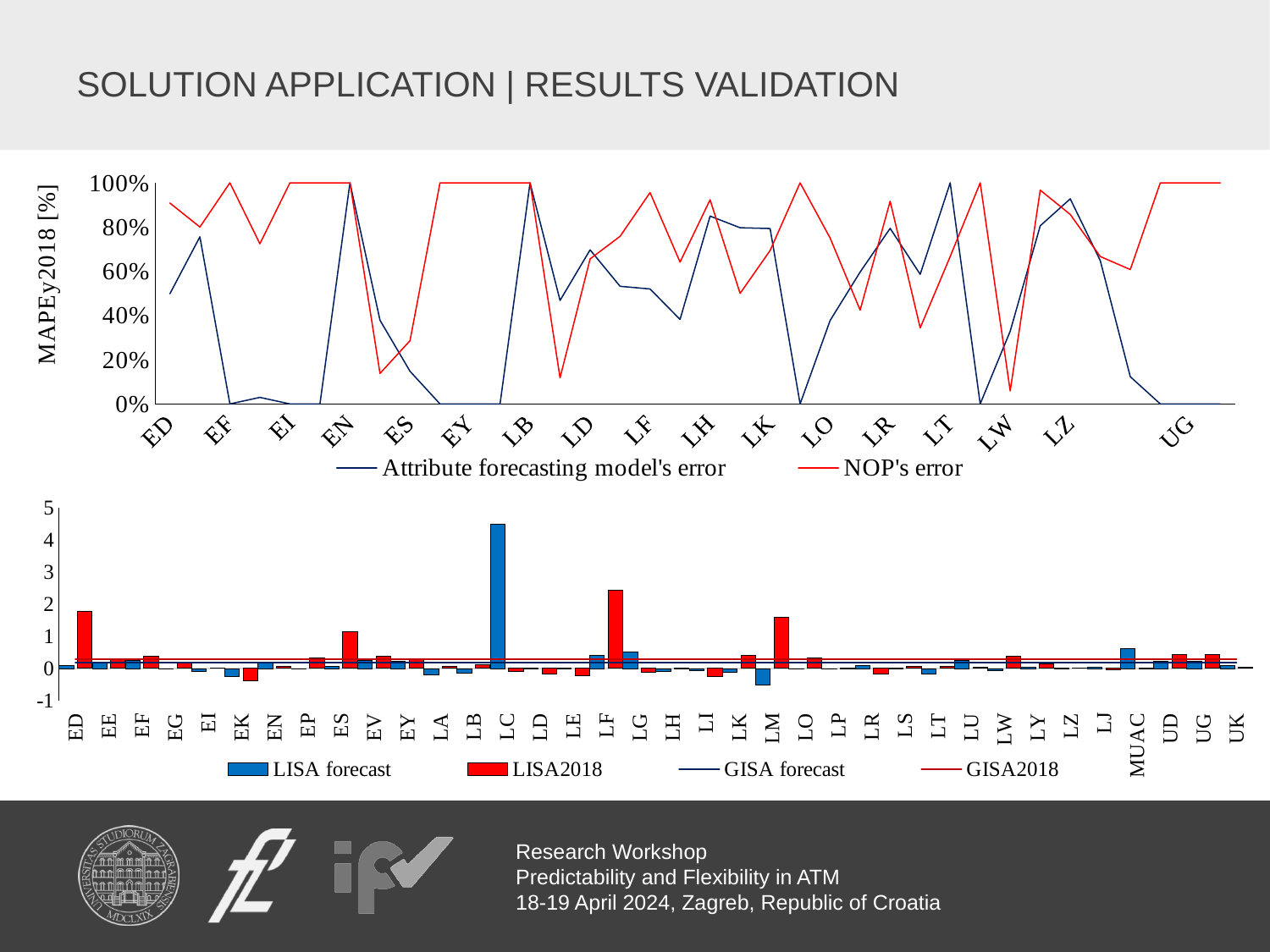
In the bottom chart, which category has the highest LISA2018 value? LF In the top chart, is the value of Attribute forecasting model's error at LO greater or less than 20%? greater In the bottom chart, which category has the highest LISA forecast value? LC In the top chart, is the value of Attribute forecasting model's error at EN greater or less than 80%? greater In the top chart, what is the y-axis title? MAPEy2018 [%] In the top chart, which series has the larger value at LB, Attribute forecasting model's error or NOP's error? Neither; both are 100% How many series does the legend of the bottom chart list? 4 In the bottom chart, is the LISA forecast value for LC greater or less than 4? greater What kind of chart is the top chart on the slide? line chart How many categories are shown on the x axis of the bottom chart? 36 How many series does the legend of the top chart list? 2